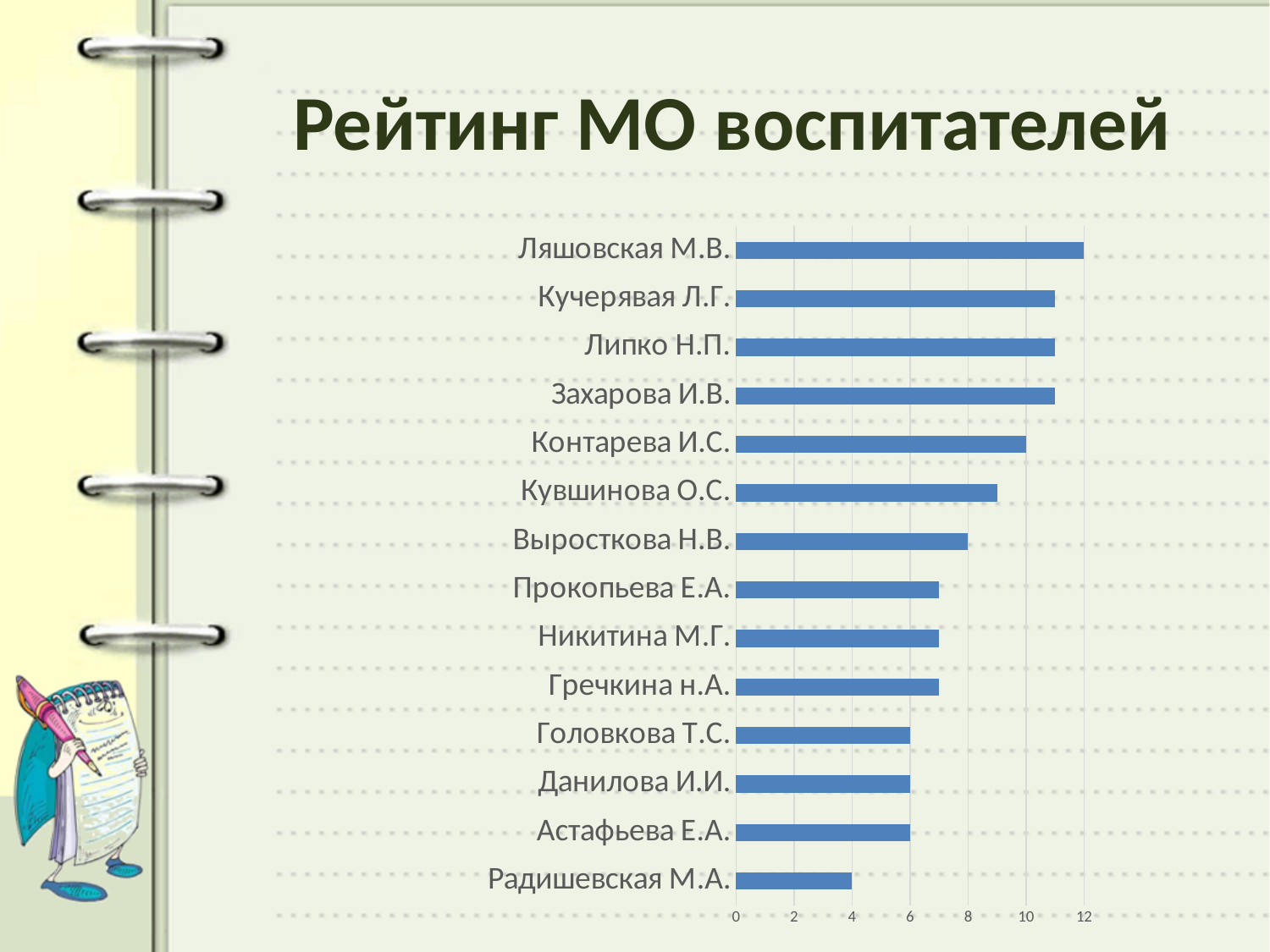
What is the value for Контарева И.С.? 10 What is the value for Радишевская М.А.? 4 How many categories (names) are plotted in the chart? 14 Which has the larger value, Контарева И.С. or Кувшинова О.С.? Контарева И.С. What is the title of the chart on the slide? Рейтинг МО воспитателей What is the value for Ляшовская М.В.? 12 What kind of chart is shown on the slide? bar chart Is the value for Кучерявая Л.Г. greater or less than 10? greater Which category has the highest value in the chart? Ляшовская М.В. What is the value for Выросткова Н.В.? 8 Which category has the lowest value in the chart? Радишевская М.А. What is the difference between the values for Ляшовская М.В. and Радишевская М.А.? 8